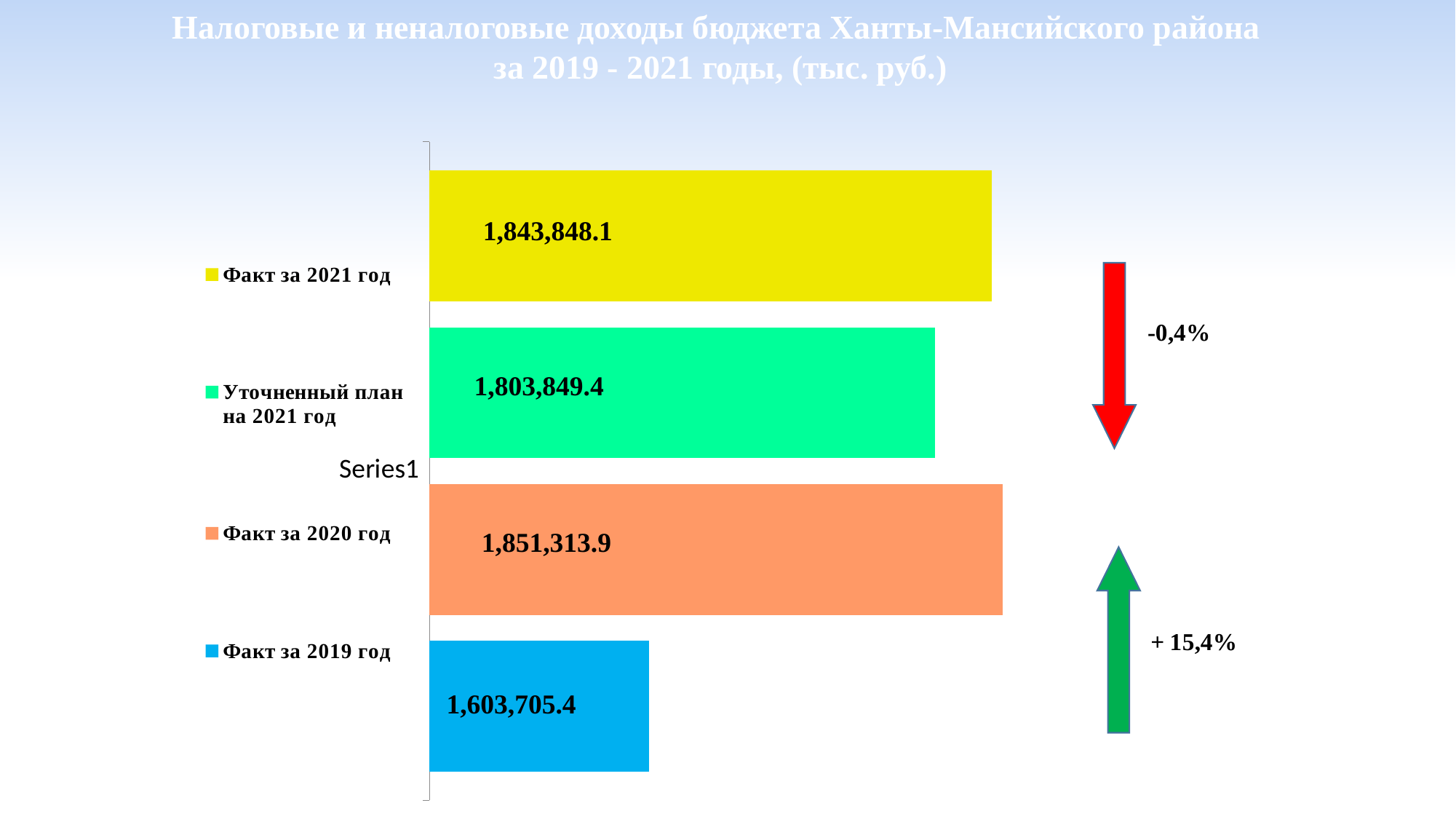
Which category has the highest value? Факт за 2020 год What is the value for Уточненный план на 2021 год? 1,803,849.4 What is the difference between Факт за 2021 год and Уточненный план на 2021 год? 39,998.7 What colour is the bar for Факт за 2019 год? Blue What is the value for Факт за 2019 год? 1,603,705.4 What is the value for Факт за 2021 год? 1,843,848.1 How many bars are shown in the chart? 4 What is the difference between Факт за 2020 год and Факт за 2019 год? 247,608.5 What kind of chart is shown on the slide? Bar chart What is the value for Факт за 2020 год? 1,851,313.9 Which is larger, Факт за 2021 год or Факт за 2019 год? Факт за 2021 год Which category has the lowest value? Факт за 2019 год